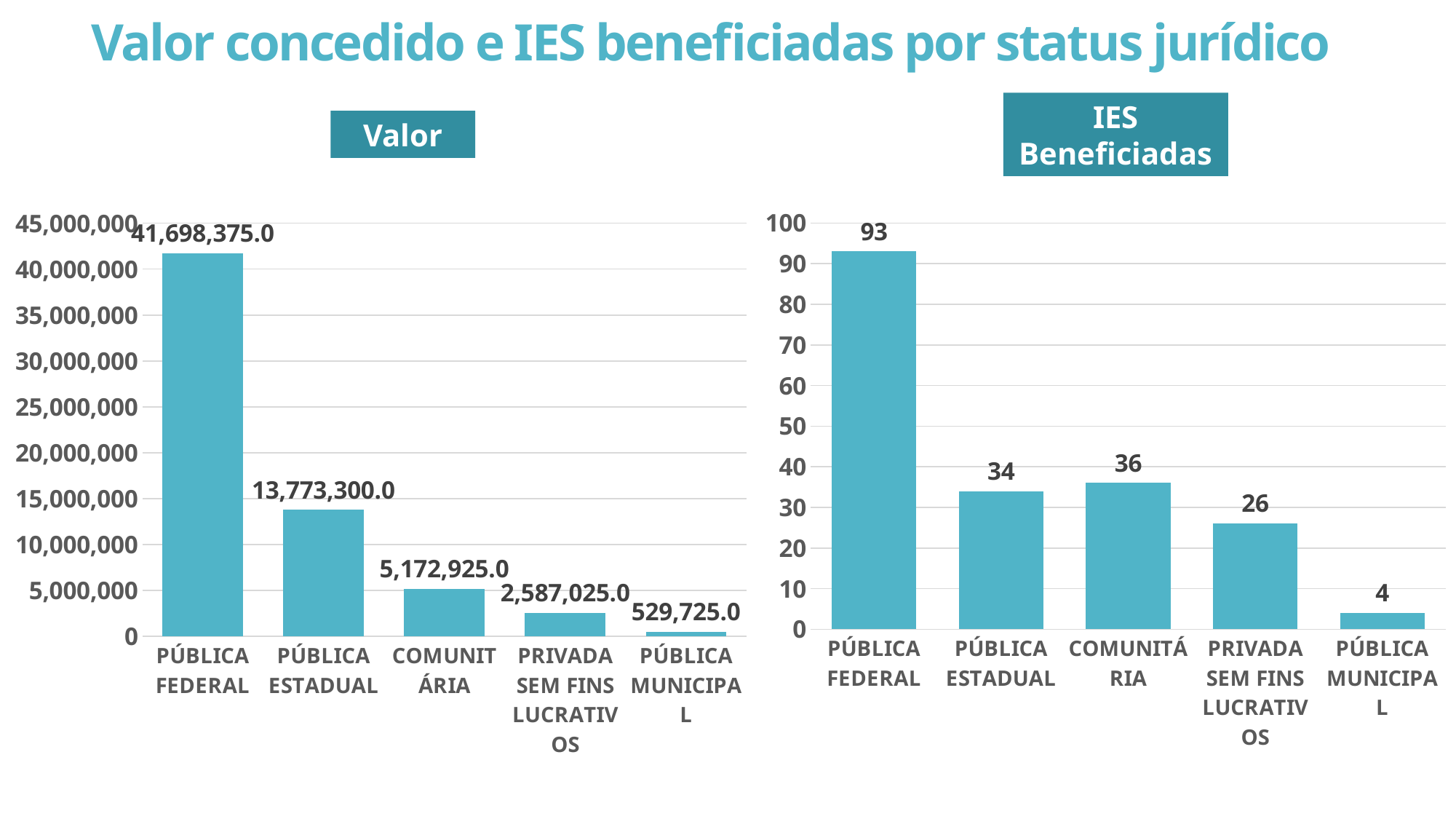
In the Valor chart, which category has the lowest value? Pública Municipal In the Valor chart, what is the value for Pública Federal? 41,698,375.0 In the Valor chart, is the value for Pública Estadual greater or less than 10,000,000? greater How many categories are shown in the IES Beneficiadas chart? 5 What is the title of the slide? Valor concedido e IES beneficiadas por status jurídico In the IES Beneficiadas chart, what is the value for Privada sem fins lucrativos? 26 In the Valor chart, what is the difference between Pública Federal and Pública Estadual? 27,925,075.0 In the IES Beneficiadas chart, which category has the highest value? Pública Federal In the IES Beneficiadas chart, which is larger, Comunitária or Pública Estadual? Comunitária In the IES Beneficiadas chart, what is the difference between Comunitária and Pública Estadual? 2 In the Valor chart, what is the value for Comunitária? 5,172,925.0 What kind of chart is the Valor chart? bar chart